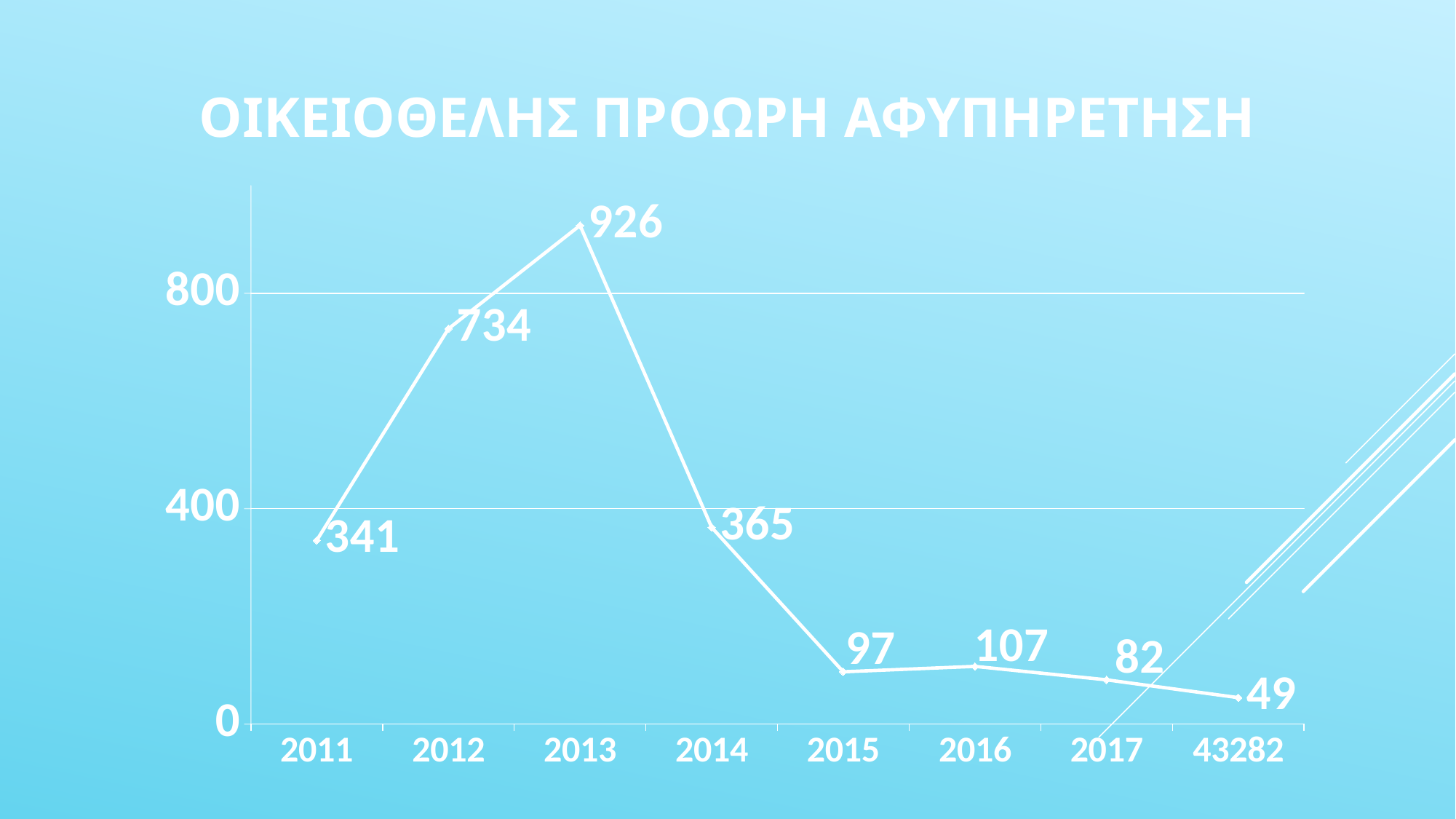
Which year has the highest value? 2013 What is the value for 2011? 341 What kind of chart is shown on the slide? line chart How many data points are plotted on the chart? 8 What is the title of the chart? ΟΙΚΕΙΟΘΕΛΗΣ ΠΡΟΩΡΗ ΑΦΥΠΗΡΕΤΗΣΗ What is the value for 2016? 107 What is the difference between the values for 2013 and 2012? 192 Which category has the lowest value? 43282 What is the difference between the values for 2014 and 2015? 268 What is the value for the category labelled 43282? 49 Which is larger, the value for 2015 or the value for 2016? 2016 What is the value for 2013? 926